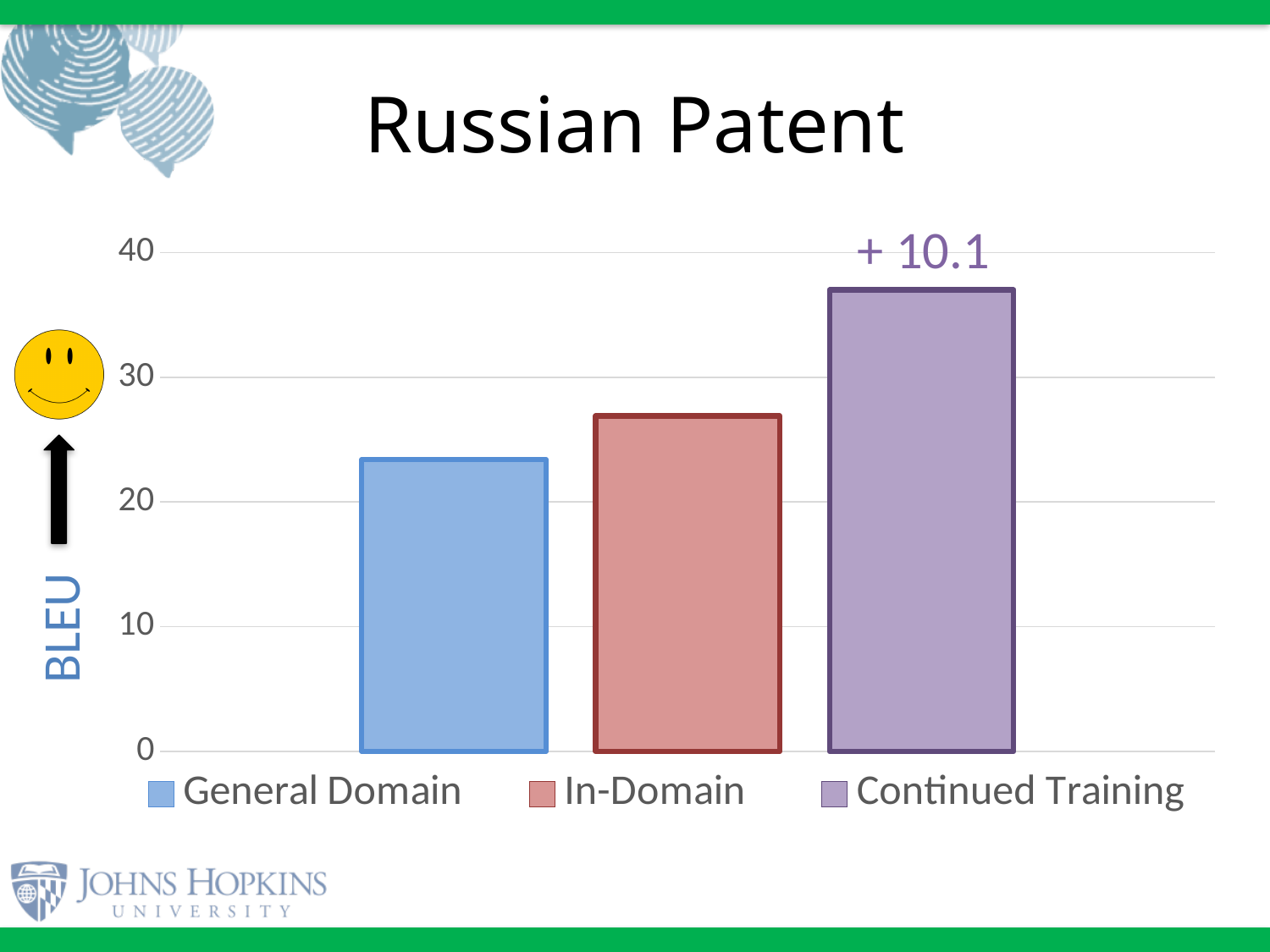
Which has a higher BLEU score, Continued Training or In-Domain? Continued Training How many bars are plotted in the chart? 3 How many series does the legend list? 3 Do the bar values rise or fall from left to right across the chart? rise Which has a higher BLEU score, In-Domain or General Domain? In-Domain Which series has the highest BLEU score? Continued Training Is the value for In-Domain greater or less than 30? less What annotation is printed above the Continued Training bar? + 10.1 Is the value for Continued Training greater or less than 30? greater Which series has the lowest BLEU score? General Domain What kind of chart is shown on the slide? bar chart Is the value for General Domain greater or less than 20? greater